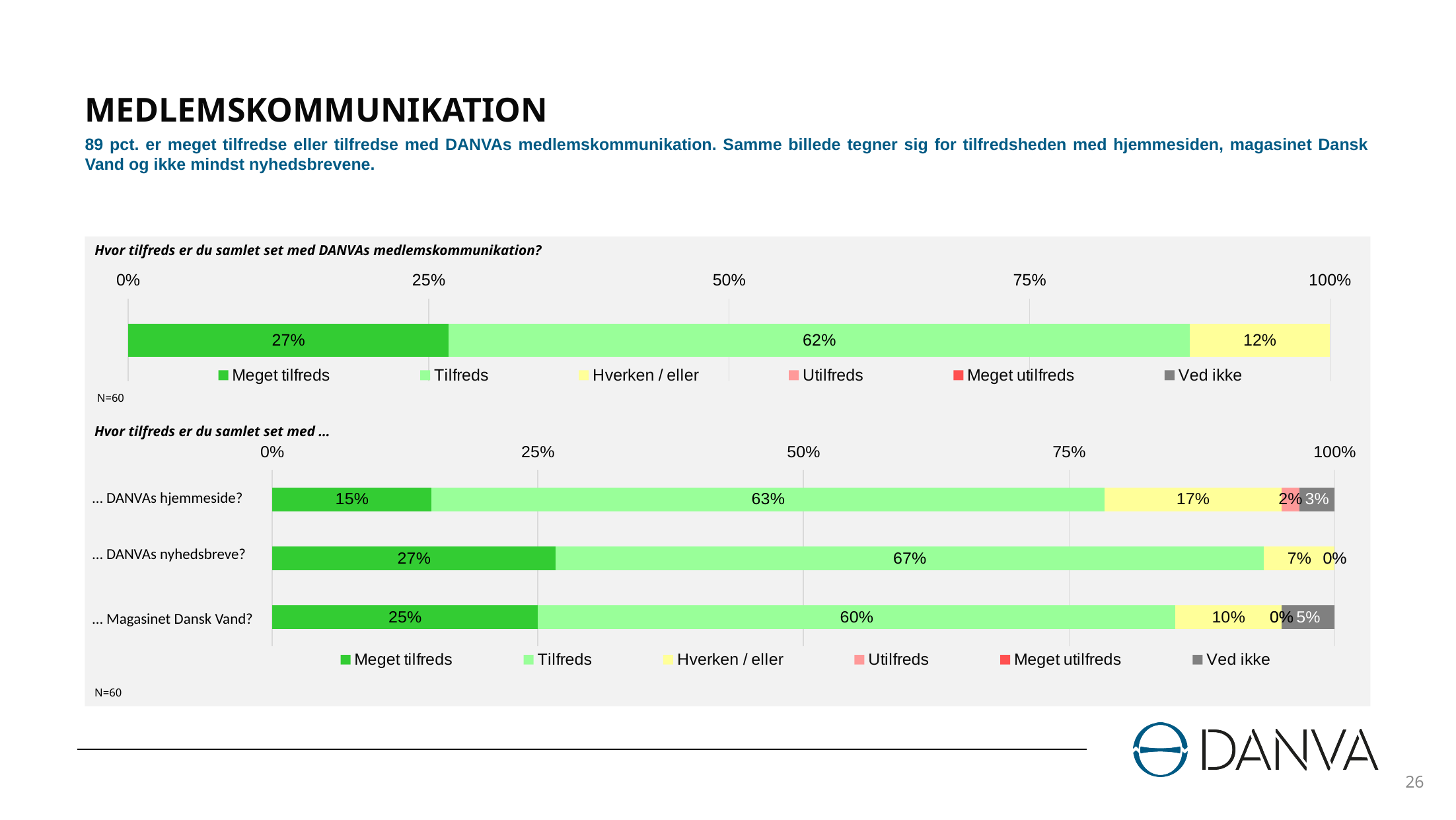
What kind of chart is the bottom chart (Hvor tilfreds er du samlet set med ...)? Stacked bar chart In the bottom chart (Hvor tilfreds er du samlet set med ...), what is the Hverken / eller value for ... Magasinet Dansk Vand? 10% In the top chart (Hvor tilfreds er du samlet set med DANVAs medlemskommunikation?), what percentage answered Tilfreds? 62% In the bottom chart (Hvor tilfreds er du samlet set med ...), which category has the highest Meget tilfreds value? ... DANVAs nyhedsbreve? In the bottom chart (Hvor tilfreds er du samlet set med ...), what is the difference between the Tilfreds values for ... DANVAs nyhedsbreve? and ... Magasinet Dansk Vand? 7% In the bottom chart (Hvor tilfreds er du samlet set med ...), what is the Meget tilfreds value for ... DANVAs hjemmeside? 15% In the top chart (Hvor tilfreds er du samlet set med DANVAs medlemskommunikation?), what percentage answered Hverken / eller? 12% In the bottom chart (Hvor tilfreds er du samlet set med ...), which category has the lowest Meget tilfreds value? ... DANVAs hjemmeside? In the bottom chart (Hvor tilfreds er du samlet set med ...), what is the Tilfreds value for ... DANVAs nyhedsbreve? 67% In the bottom chart (Hvor tilfreds er du samlet set med ...), how many categories are shown? 3 In the top chart (Hvor tilfreds er du samlet set med DANVAs medlemskommunikation?), how many series does the legend list? 6 In the top chart (Hvor tilfreds er du samlet set med DANVAs medlemskommunikation?), what percentage answered Meget tilfreds? 27%